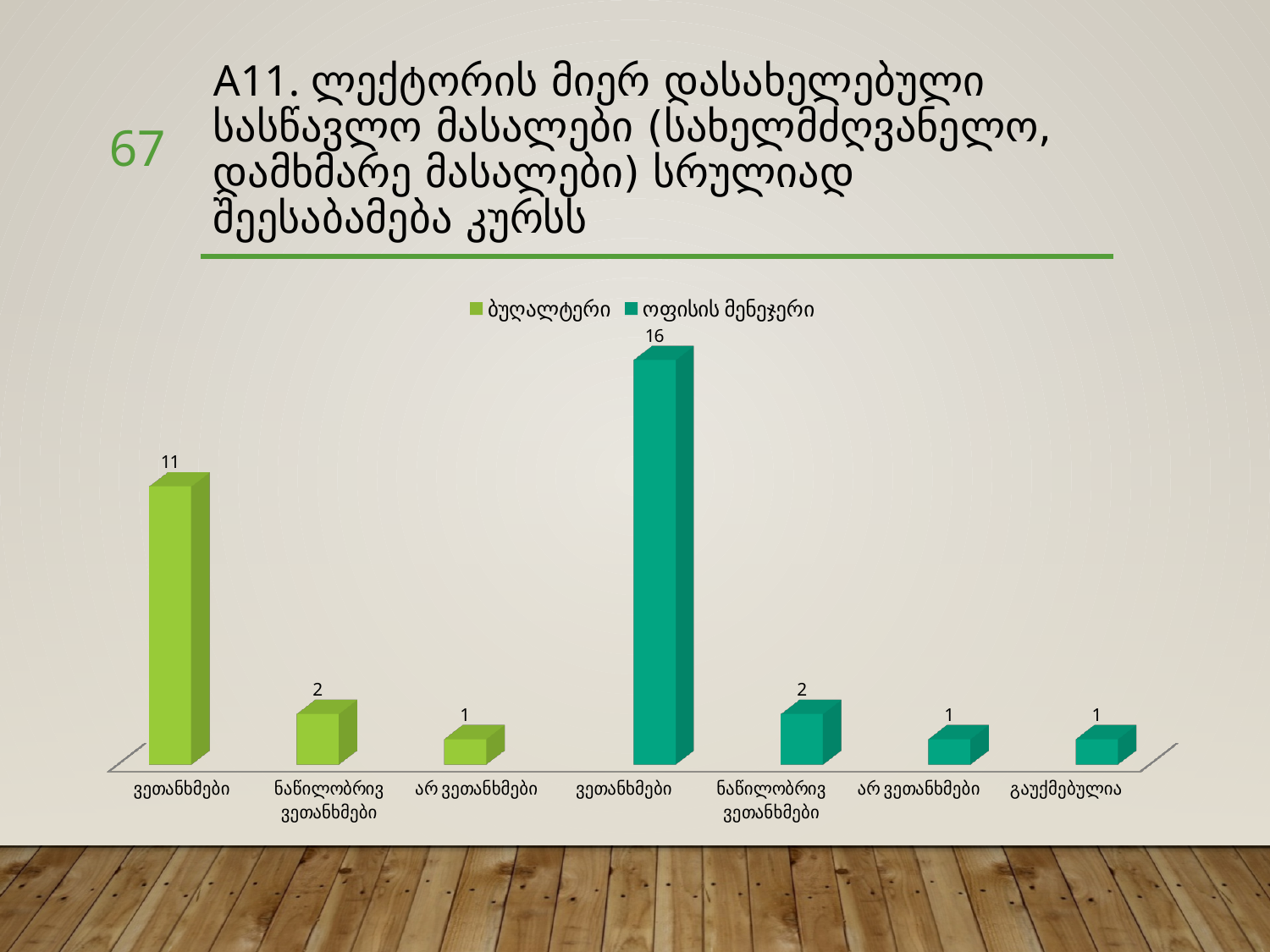
What kind of chart is shown on the slide? bar chart Which bar has the highest value in the chart? ვეთანხმები (ოფისის მენეჯერი) What is the value of the ვეთანხმები bar for the ბუღალტერი series? 11 What is the value of the ვეთანხმები bar for the ოფისის მენეჯერი series? 16 What is the value of the ნაწილობრივ ვეთანხმები bar for the ბუღალტერი series? 2 What is the total of the three ბუღალტერი bars (ვეთანხმები, ნაწილობრივ ვეთანხმები, არ ვეთანხმები)? 14 How many series does the legend list? 2 What is the difference between the ვეთანხმები values for ოფისის მენეჯერი and ბუღალტერი? 5 Which is larger: the ვეთანხმები value for ბუღალტერი or for ოფისის მენეჯერი? ოფისის მენეჯერი How many bars are plotted in the chart? 7 What are the two series named in the legend? ბუღალტერი and ოფისის მენეჯერი What is the value of the გაუქმებულია bar for the ოფისის მენეჯერი series? 1